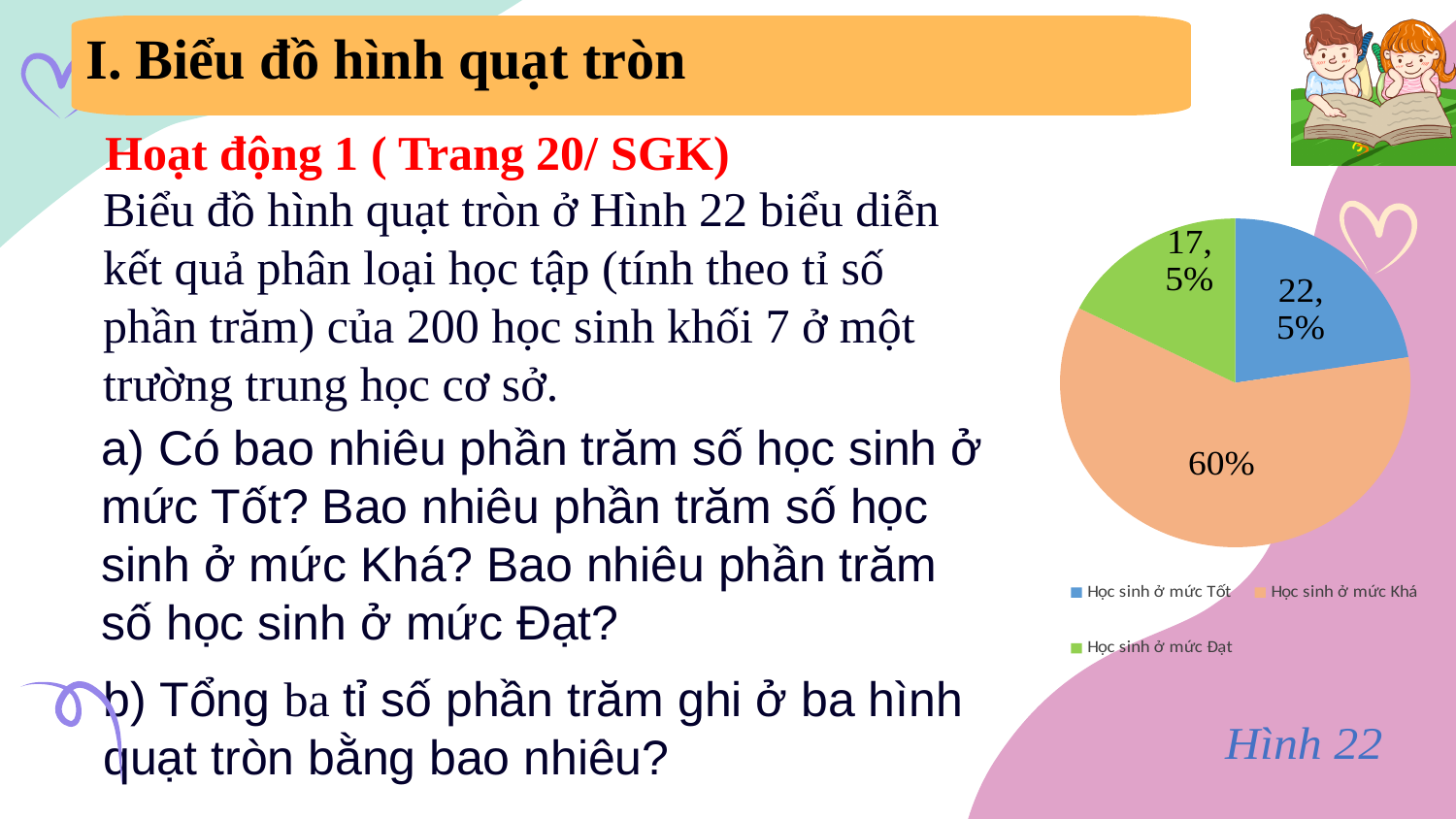
Which category has the largest slice of the pie? Học sinh ở mức Khá What percentage of students are at the Tốt level (Học sinh ở mức Tốt)? 22,5% How many entries does the legend list? 3 What colour is the slice for Học sinh ở mức Khá? orange Which category has the smallest slice of the pie? Học sinh ở mức Đạt Which is larger, the share for Học sinh ở mức Tốt or for Học sinh ở mức Đạt? Học sinh ở mức Tốt What percentage of students are at the Đạt level (Học sinh ở mức Đạt)? 17,5% What kind of chart is shown on the slide? pie chart What is the difference in percentage points between the Khá slice and the Tốt slice? 37,5% What percentage of students are at the Khá level (Học sinh ở mức Khá)? 60% What is the sum of the three percentages shown on the pie chart? 100% How many slices does the pie chart have? 3